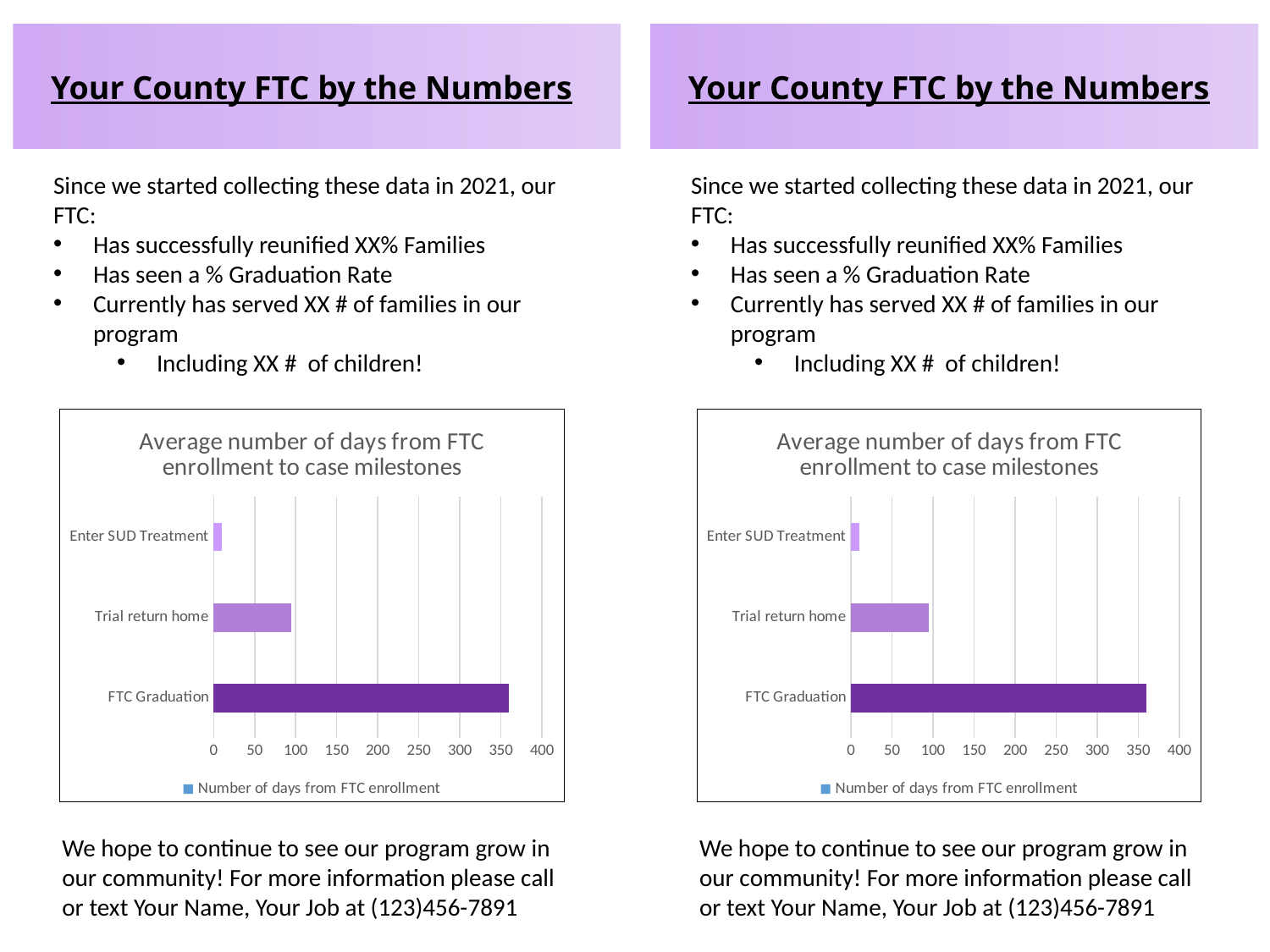
On the left chart, how many categories are plotted? 3 What is the title of the chart on the right? Average number of days from FTC enrollment to case milestones On the left chart, what is the legend entry for the plotted series? Number of days from FTC enrollment On the right chart, is the value for FTC Graduation greater or less than 300? greater On the right chart, which milestone has the lowest average number of days from FTC enrollment? Enter SUD Treatment On the left chart, which milestone has the highest average number of days from FTC enrollment? FTC Graduation On the left chart, which is larger: the value for Trial return home or the value for Enter SUD Treatment? Trial return home On the left chart, is the value for Trial return home greater or less than 150? less On the left chart, what kind of chart is shown? Bar chart On the right chart, how many series does the legend list? 1 On the left chart, is the value for Trial return home greater or less than 50? greater